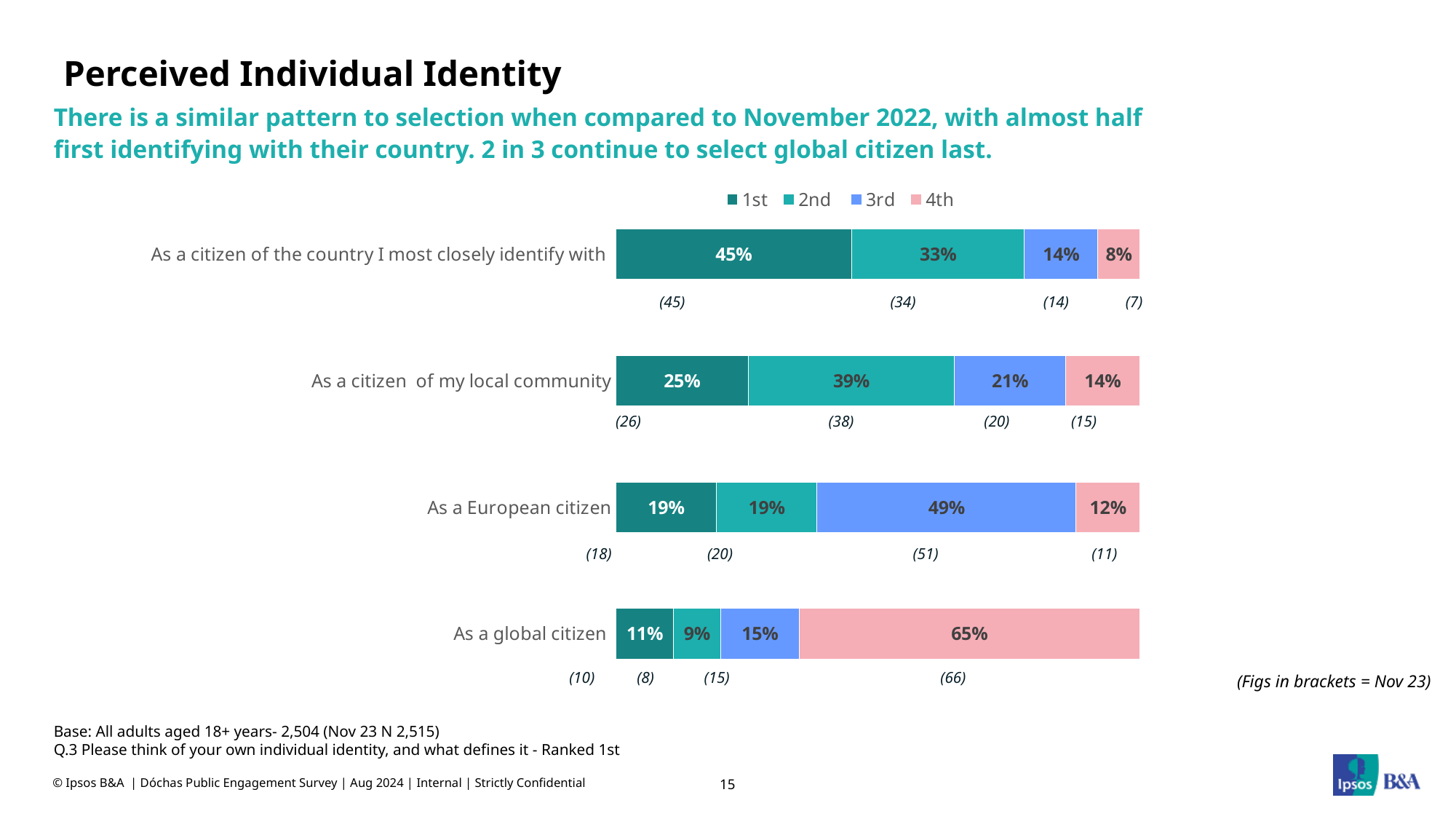
Which category has the highest share ranked 1st? As a citizen of the country I most closely identify with What percentage ranked 'As a citizen of my local community' 2nd? 39% Which category has the lowest share ranked 1st? As a global citizen What is the difference between the 2nd-ranked share for 'As a citizen of my local community' and for 'As a global citizen'? 30 percentage points How many categories are shown in the chart? 4 What percentage ranked 'As a global citizen' 4th? 65% What percentage ranked 'As a citizen of the country I most closely identify with' 1st? 45% Which is larger: the 3rd-ranked share for 'As a European citizen' or for 'As a citizen of my local community'? As a European citizen What kind of chart is shown on the slide? Stacked bar chart What percentage ranked 'As a European citizen' 3rd? 49% How many series does the legend list? 4 What do the figures in brackets below the bars represent? Nov 23 figures